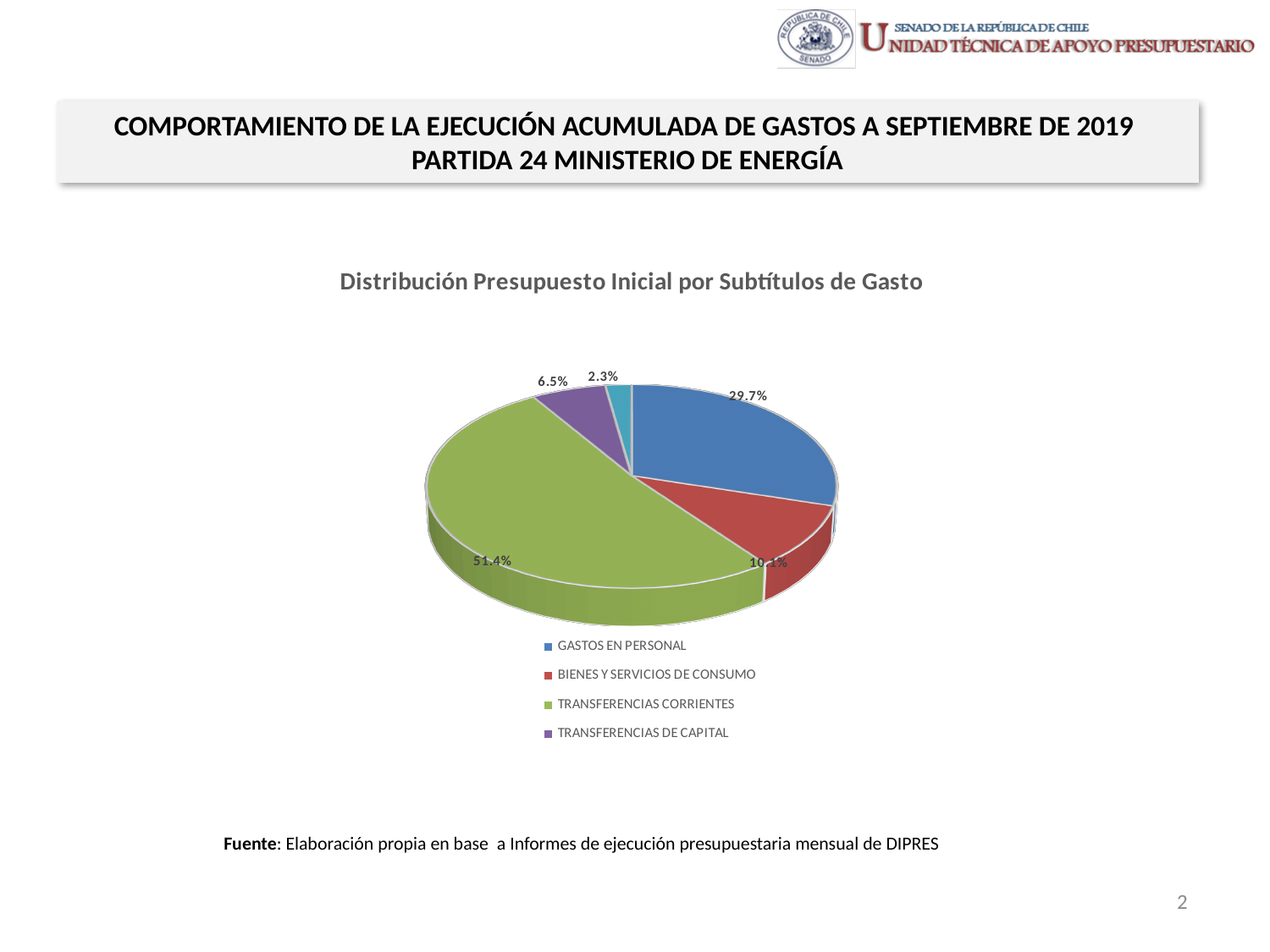
What percentage of the pie chart corresponds to TRANSFERENCIAS CORRIENTES? 51.4% What kind of chart is shown on the slide? Pie chart Which is larger, the share for GASTOS EN PERSONAL or the share for BIENES Y SERVICIOS DE CONSUMO? GASTOS EN PERSONAL How many entries does the legend of the pie chart list? 4 What is the title of the chart on the slide? Distribución Presupuesto Inicial por Subtítulos de Gasto By how many percentage points does TRANSFERENCIAS CORRIENTES exceed GASTOS EN PERSONAL? 21.7 percentage points What is the smallest percentage value shown on the pie chart? 2.3% What percentage of the pie chart corresponds to GASTOS EN PERSONAL? 29.7% Which category has the largest slice of the pie chart? TRANSFERENCIAS CORRIENTES What percentage of the pie chart corresponds to BIENES Y SERVICIOS DE CONSUMO? 10.1% What percentage of the pie chart corresponds to TRANSFERENCIAS DE CAPITAL? 6.5% How many slices does the pie chart have? 5